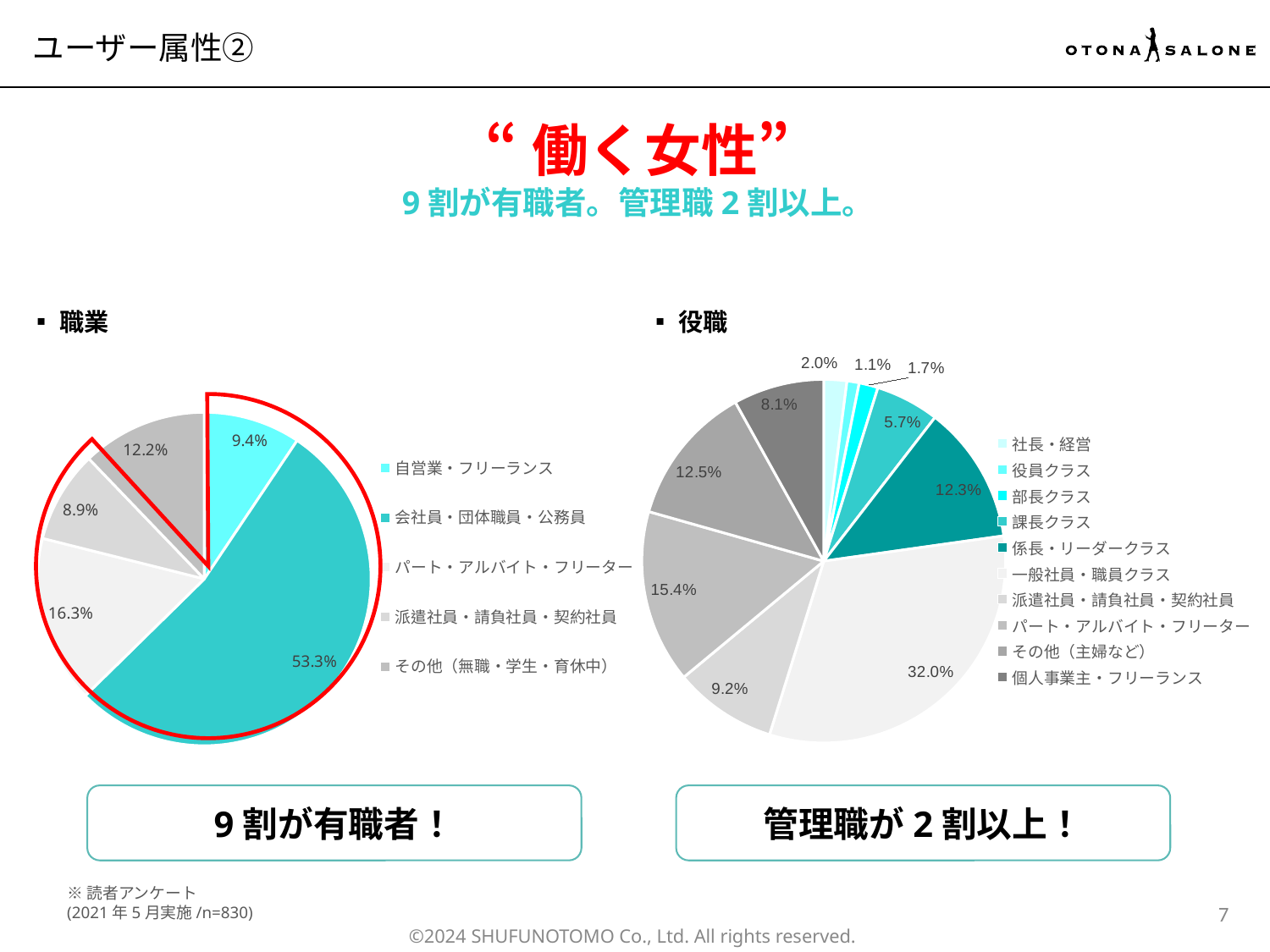
In the 職業 pie chart, what is the difference between the shares of その他（無職・学生・育休中） and 自営業・フリーランス? 2.8% In the 役職 pie chart, what percentage is shown for 一般社員・職員クラス? 32.0% In the 職業 pie chart, what percentage is shown for 会社員・団体職員・公務員? 53.3% In the 役職 pie chart, what is the difference between the shares of 係長・リーダークラス and 個人事業主・フリーランス? 4.2% In the 職業 pie chart, which category has the smallest share? 派遣社員・請負社員・契約社員 How many categories does the 職業 pie chart have? 5 In the 役職 pie chart, which category has the smallest share? 役員クラス In the 職業 pie chart, what percentage is shown for パート・アルバイト・フリーター? 16.3% What type of chart is used for 役職? Pie chart In the 役職 pie chart, what percentage is shown for 課長クラス? 5.7% How many categories does the legend of the 役職 pie chart list? 10 In the 役職 pie chart, which is larger: パート・アルバイト・フリーター or その他（主婦など）? パート・アルバイト・フリーター